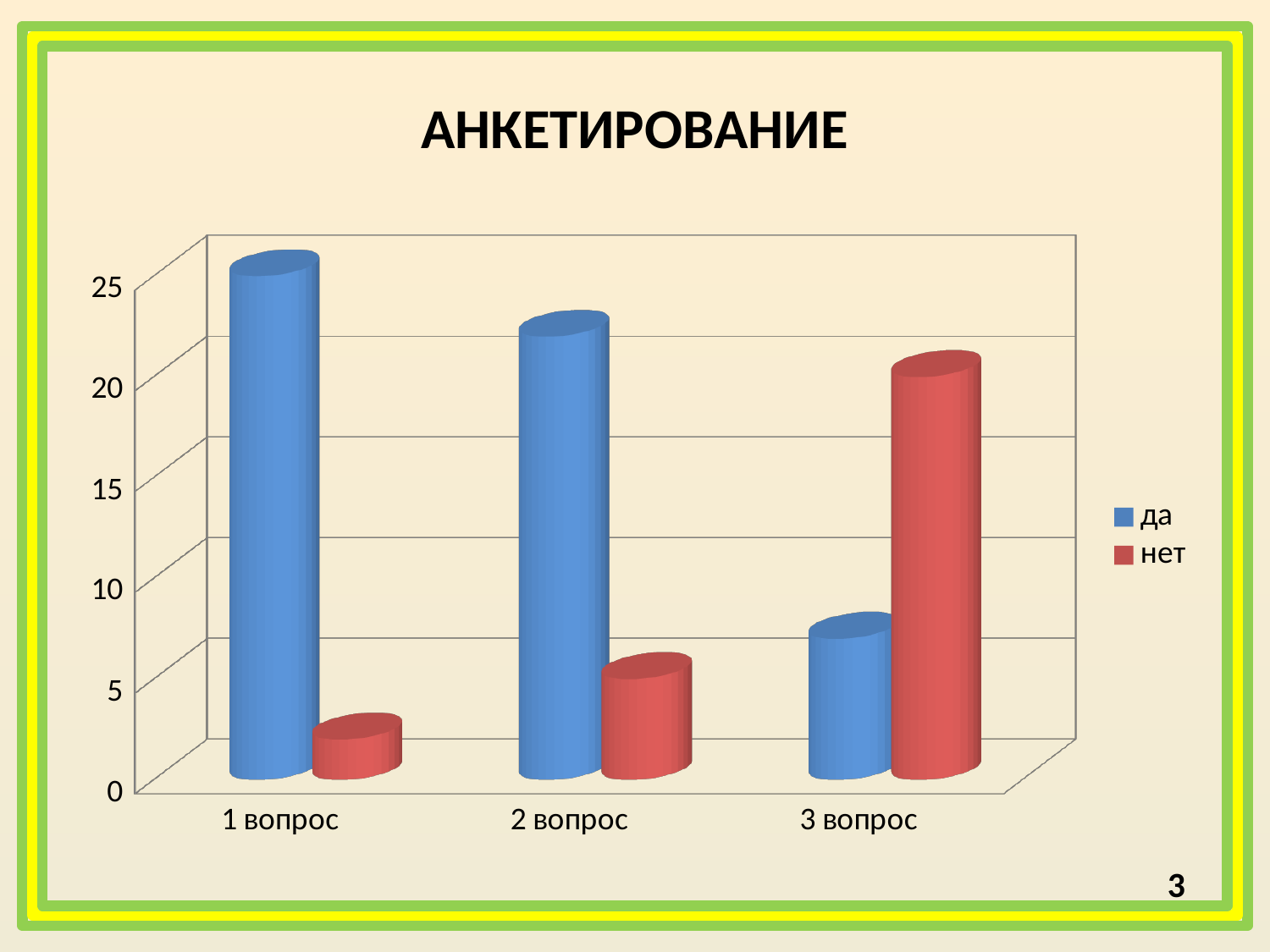
How many series does the legend list? 2 Is the value for нет at 3 вопрос greater or less than 15? greater Is the value for да at 1 вопрос greater or less than 20? greater How many categories are shown on the x axis? 3 At 3 вопрос, which is larger: да or нет? нет For which category is the нет series lowest? 1 вопрос For which category is the да series highest? 1 вопрос What is the title of the chart? АНКЕТИРОВАНИЕ Is the value for нет at 1 вопрос greater or less than 5? less What kind of chart is shown on the slide? bar chart